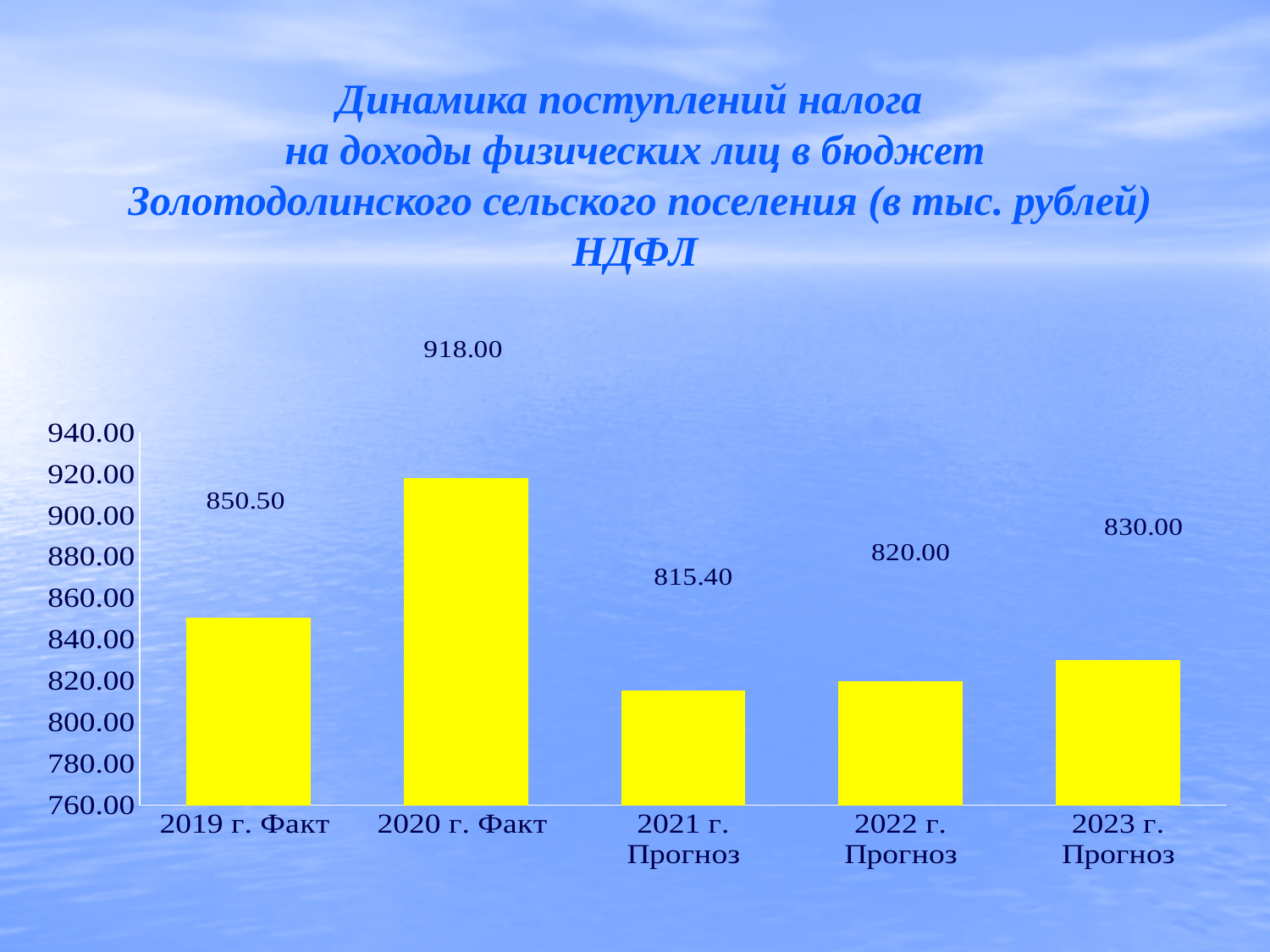
What is the value for 2020 г. Факт? 918.00 What kind of chart is shown on the slide? bar chart Which category has the lowest value? 2021 г. Прогноз Which category has the highest value? 2020 г. Факт What colour are the bars in the chart? yellow What is the difference between the values for 2020 г. Факт and 2019 г. Факт? 67.50 Which is larger, the value for 2019 г. Факт or the value for 2022 г. Прогноз? 2019 г. Факт What is the value for 2021 г. Прогноз? 815.40 What is the value for 2019 г. Факт? 850.50 What is the value for 2023 г. Прогноз? 830.00 What is the difference between the values for 2023 г. Прогноз and 2022 г. Прогноз? 10.00 How many categories are shown on the x axis? 5